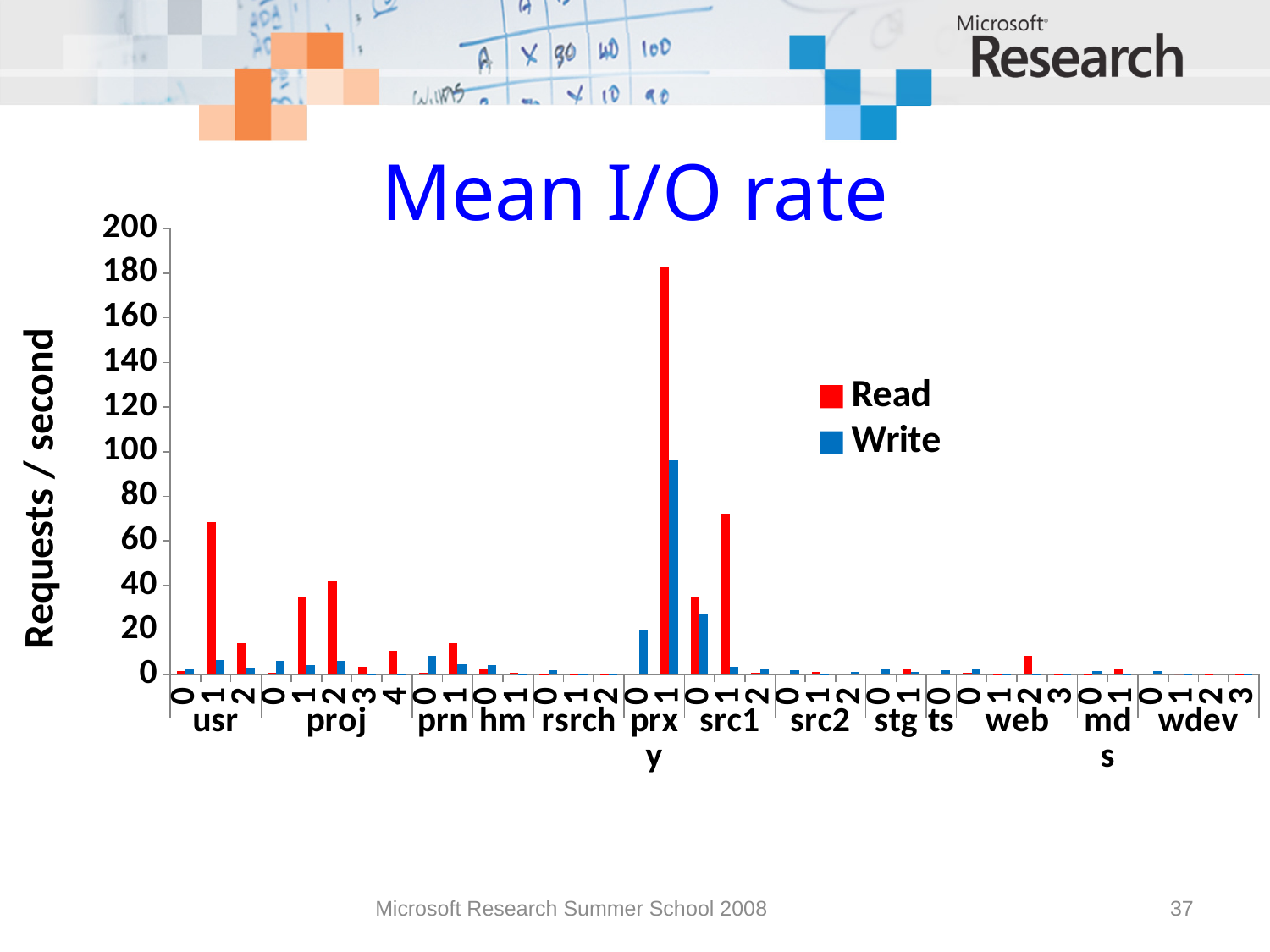
Which is larger for prxy 1, the Read value or the Write value? Read How many series does the legend list? 2 What is the label on the vertical axis? Requests / second Which is larger, the Read value for prxy 1 or the Read value for src1 1? Read for prxy 1 What kind of chart is shown on the slide? bar chart Is the Read value for usr 1 greater or less than 60? greater What is the title of the chart? Mean I/O rate Which bar is the tallest in the chart? Read for prxy 1 Is the Read value for prxy 1 greater or less than 160? greater Is the Write value for prxy 1 greater or less than 80? greater